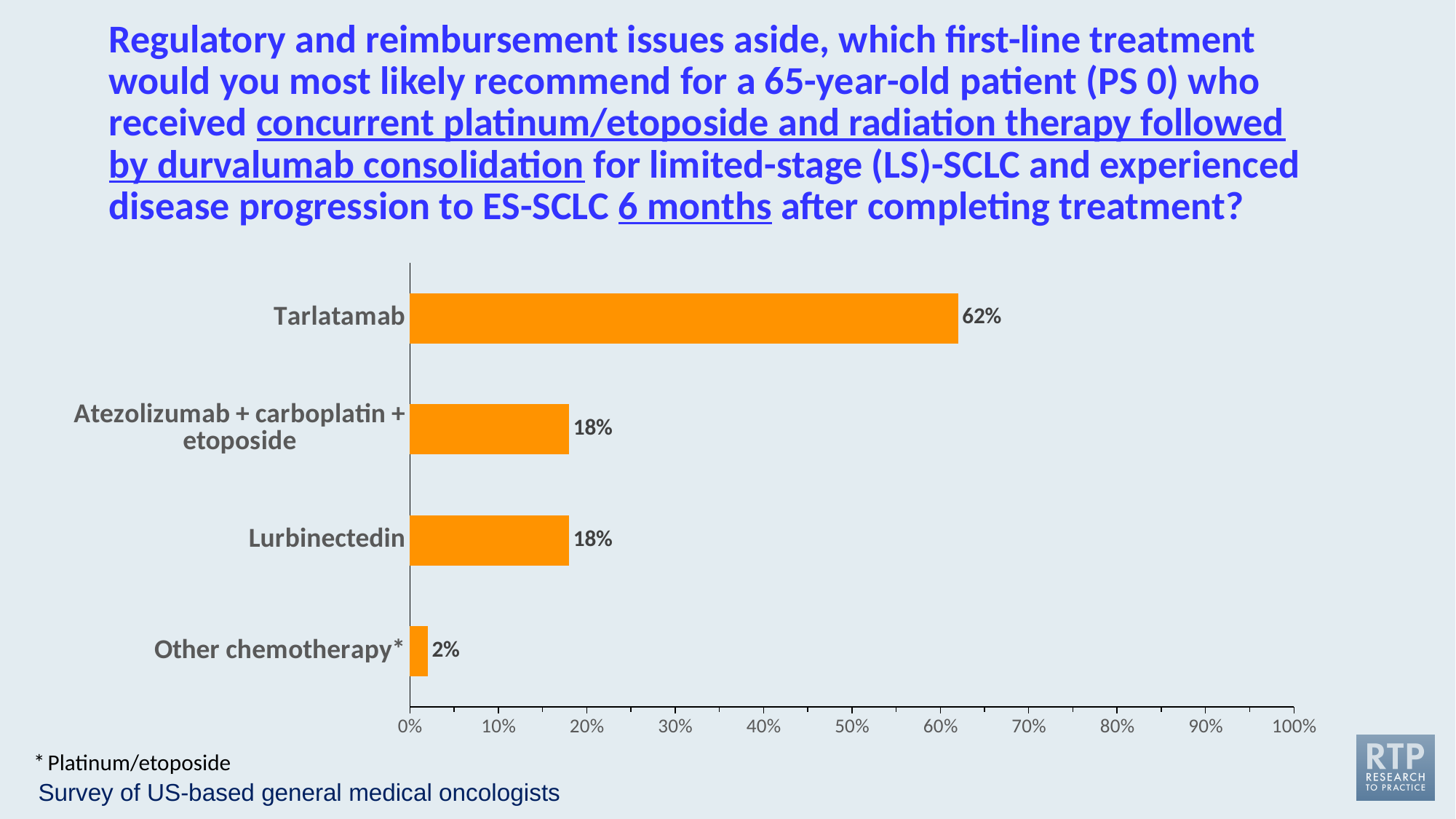
Is the value for Tarlatamab greater or less than 50%? greater What percentage of respondents chose Lurbinectedin? 18% What type of chart is shown on the slide? Bar chart How many treatment options are shown in the chart? 4 What percentage of respondents chose Other chemotherapy*? 2% What percentage of respondents chose Tarlatamab? 62% Which received a larger share of responses, Tarlatamab or Atezolizumab + carboplatin + etoposide? Tarlatamab Which treatment option received the lowest percentage of responses? Other chemotherapy* What is the difference in percentage points between Tarlatamab and Lurbinectedin? 44 What percentage of respondents chose Atezolizumab + carboplatin + etoposide? 18% Which treatment option received the highest percentage of responses? Tarlatamab What is the difference in percentage points between Atezolizumab + carboplatin + etoposide and Other chemotherapy*? 16